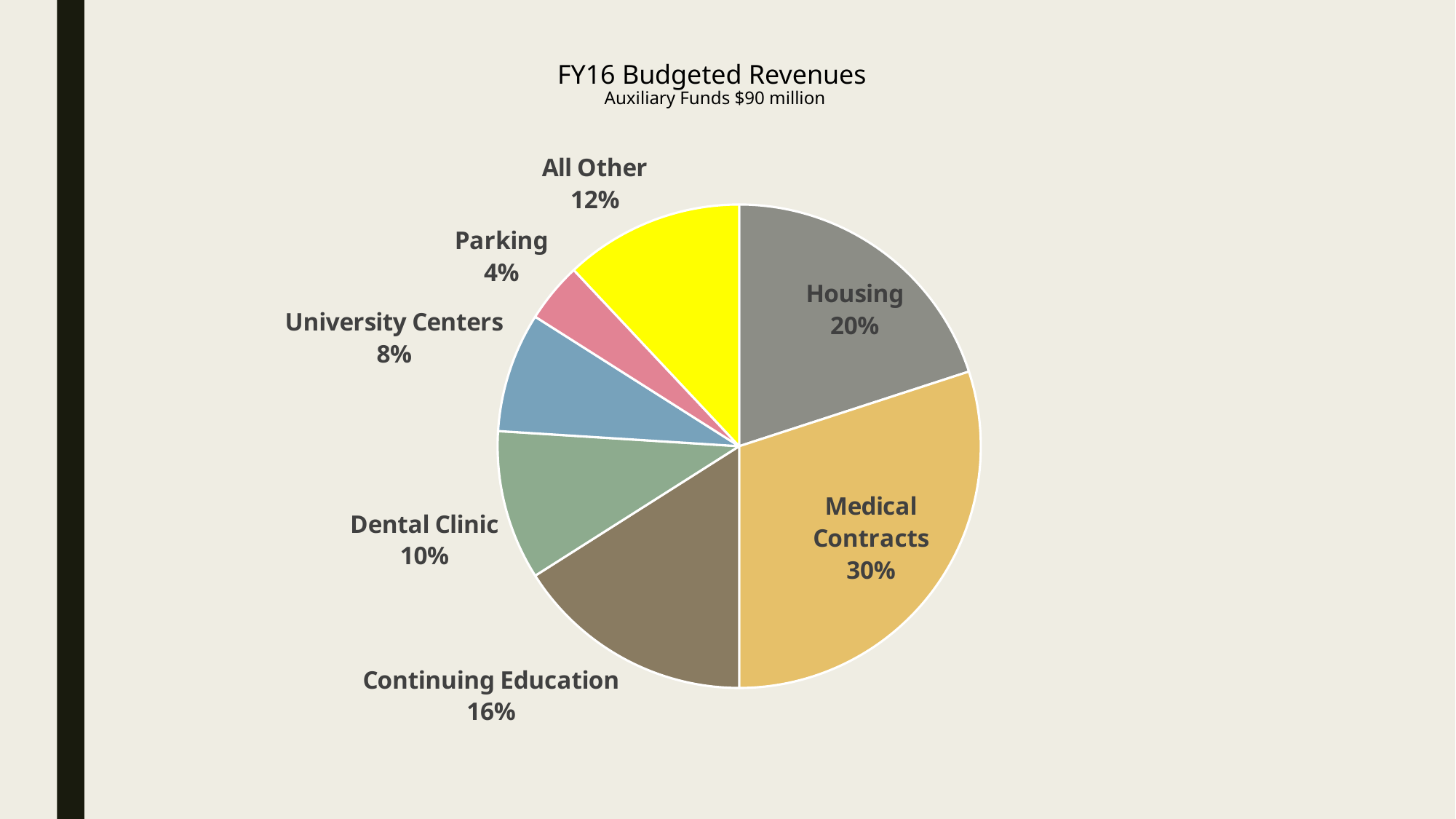
What total amount of auxiliary funds does the chart subtitle state? $90 million Which category has the smallest slice of the pie? Parking What is the difference in percentage points between Medical Contracts and Housing? 10 What is the title of the chart? FY16 Budgeted Revenues Which category has the largest slice of the pie? Medical Contracts What kind of chart is shown on the slide? Pie chart What percentage of the pie is Housing? 20% What share does Continuing Education represent? 16% Which is larger, Dental Clinic or University Centers? Dental Clinic How many categories are shown in the pie chart? 7 What percentage is shown for Parking? 4% What share of FY16 budgeted revenues comes from Medical Contracts? 30%